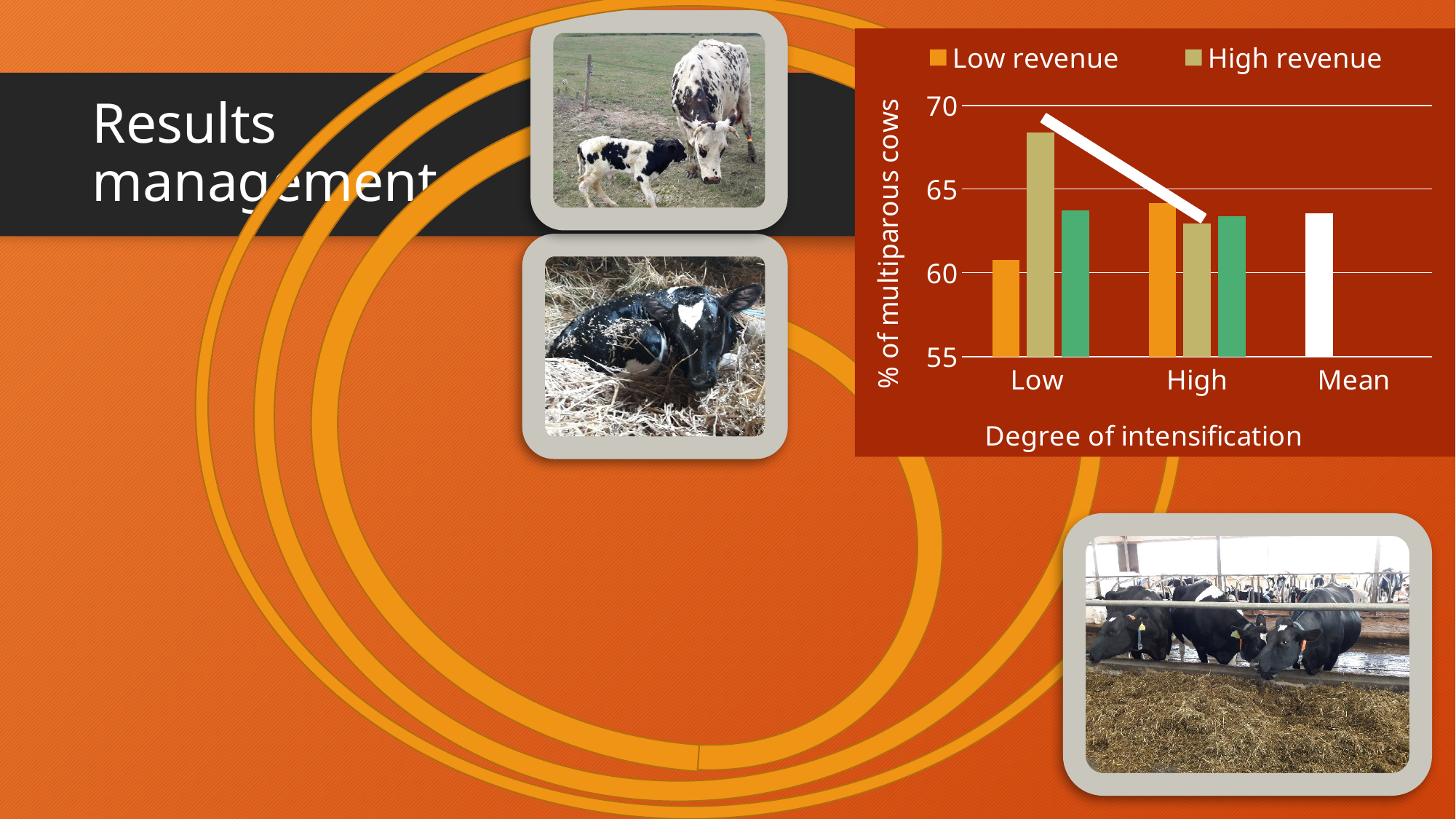
Is the Low revenue value for the Low category greater or less than 65? less What is the label of the y axis of the chart? % of multiparous cows How many series does the chart legend list? 2 In the Low category, which is larger: the Low revenue bar or the High revenue bar? High revenue What kind of chart is shown on the slide? bar chart In the High category, which is larger: the Low revenue bar or the High revenue bar? Low revenue What is the label of the x axis of the chart? Degree of intensification Is the value for the Mean category greater or less than 60? greater Is the High revenue value for the High category greater or less than 60? greater How many categories are shown on the x axis of the chart? 3 Does the High revenue series rise or fall from the Low category to the High category? fall